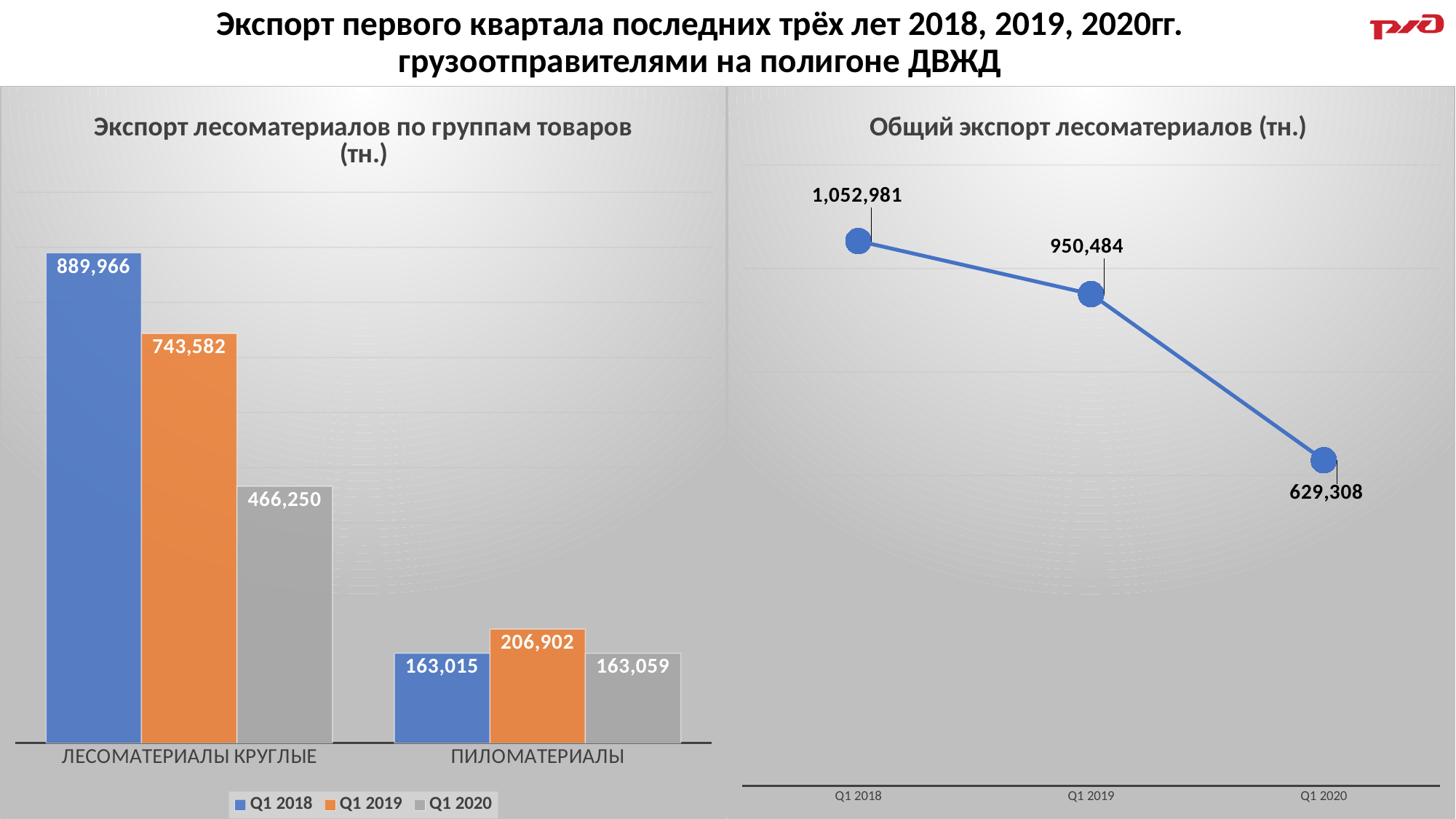
In the chart 'Общий экспорт лесоматериалов (тн.)', what is the value for Q1 2019? 950,484 What kind of chart is 'Общий экспорт лесоматериалов (тн.)'? line chart In the chart 'Общий экспорт лесоматериалов (тн.)', which period has the lowest value? Q1 2020 In the chart 'Экспорт лесоматериалов по группам товаров (тн.)', what is the value for ЛЕСОМАТЕРИАЛЫ КРУГЛЫЕ in Q1 2018? 889,966 In the chart 'Экспорт лесоматериалов по группам товаров (тн.)', how many series does the legend list? 3 In the chart 'Экспорт лесоматериалов по группам товаров (тн.)', what is the difference between the Q1 2018 and Q1 2019 values for ЛЕСОМАТЕРИАЛЫ КРУГЛЫЕ? 146,384 In the chart 'Экспорт лесоматериалов по группам товаров (тн.)', what is the value for ЛЕСОМАТЕРИАЛЫ КРУГЛЫЕ in Q1 2020? 466,250 In the chart 'Экспорт лесоматериалов по группам товаров (тн.)', what is the value for ПИЛОМАТЕРИАЛЫ in Q1 2019? 206,902 In the chart 'Общий экспорт лесоматериалов (тн.)', what is the difference between the Q1 2018 and Q1 2020 values? 423,673 In the chart 'Экспорт лесоматериалов по группам товаров (тн.)', which series has the highest value for ЛЕСОМАТЕРИАЛЫ КРУГЛЫЕ? Q1 2018 In the chart 'Общий экспорт лесоматериалов (тн.)', do the values rise or fall from Q1 2018 to Q1 2020? fall What kind of chart is 'Экспорт лесоматериалов по группам товаров (тн.)'? bar chart